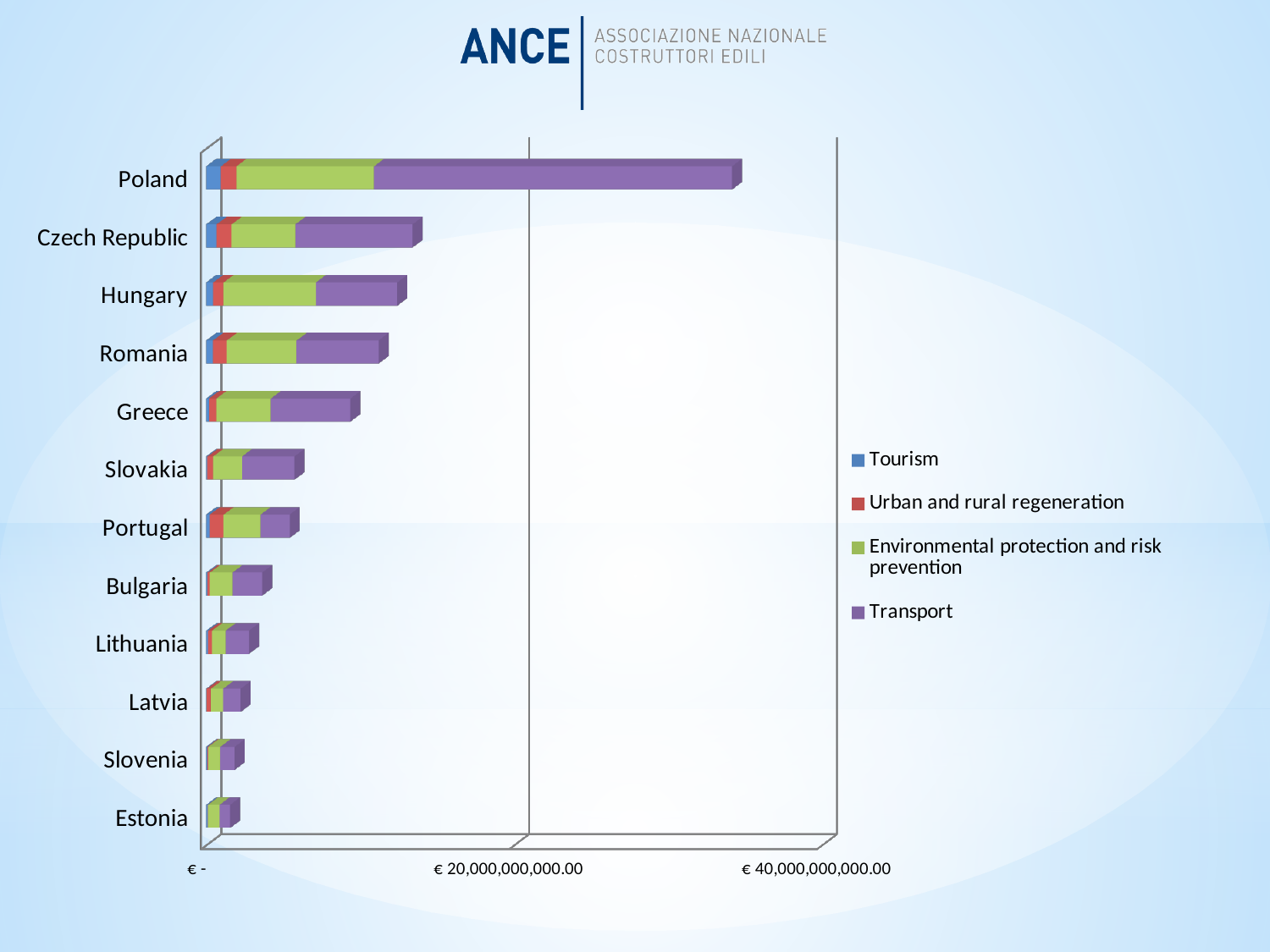
Which series makes up the largest segment of Poland's bar? Transport Which country has the longest total bar? Poland What kind of chart is shown on the slide? Stacked bar chart Is the total value for Poland greater or less than € 40,000,000,000.00? less Which has a larger total bar, Hungary or Slovakia? Hungary How many series does the legend list? 4 Which has a larger total bar, Bulgaria or Greece? Greece How many countries are listed on the chart? 12 Is the total value for Czech Republic greater or less than € 20,000,000,000.00? less Which country has the shortest total bar? Estonia Which series is shown in purple in the legend? Transport Is the total value for Poland greater or less than € 20,000,000,000.00? greater